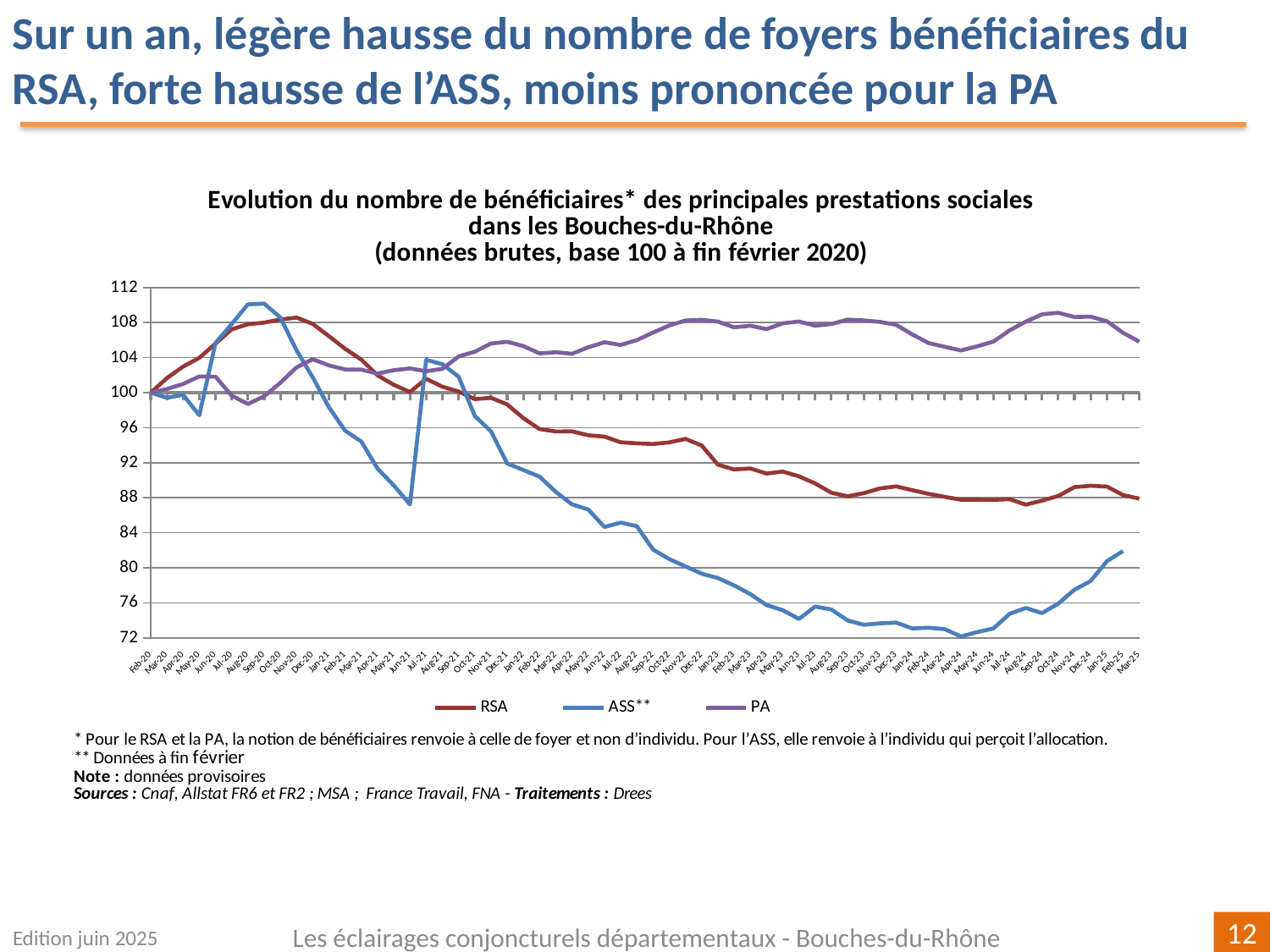
Is the value for PA in Oct-24 greater or less than 108? greater Which series are listed in the legend? RSA, ASS**, PA Which series has the lowest value in Mar-25? RSA Is the value for RSA in Dec-22 greater or less than 96? less Is the value for ASS** in Dec-22 greater or less than 84? less What kind of chart is shown on the slide? line chart What colour is the line for ASS**? blue Which series has the highest value in Mar-25? PA Does the RSA line rise or fall between Nov-20 and Mar-25? fall How many series does the legend list? 3